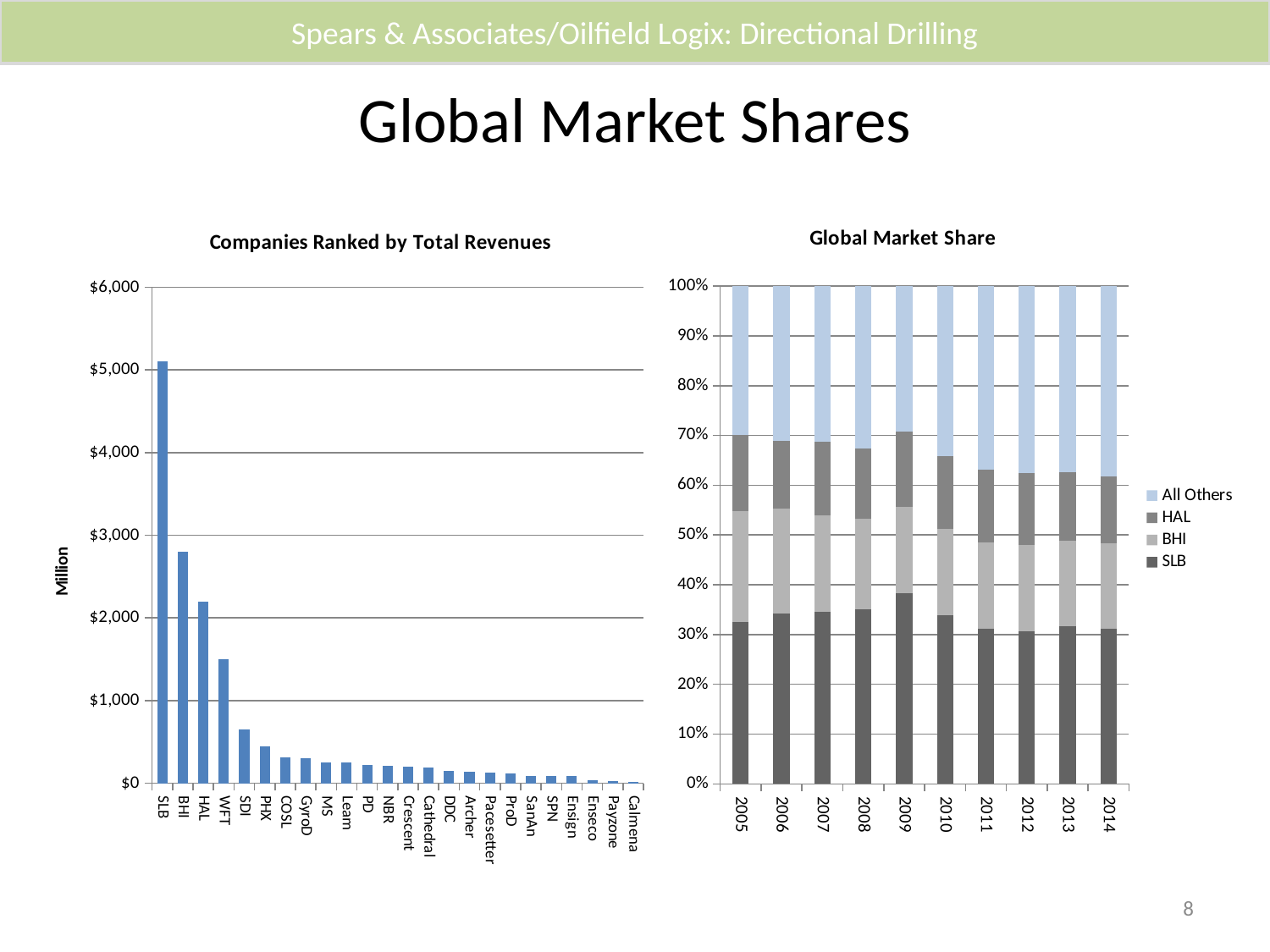
In the 'Global Market Share' chart, is the SLB share in 2009 greater or less than 30%? greater In the 'Companies Ranked by Total Revenues' chart, is the value for WFT greater or less than $1,000? greater In the 'Companies Ranked by Total Revenues' chart, which has the larger revenue, BHI or HAL? BHI How many companies are shown in the 'Companies Ranked by Total Revenues' chart? 24 How many years are shown on the x axis of the 'Global Market Share' chart? 10 In the 'Companies Ranked by Total Revenues' chart, which company has the highest total revenue? SLB In the 'Companies Ranked by Total Revenues' chart, is the value for SLB greater or less than $4,000? greater What kind of chart is the 'Global Market Share' chart? stacked bar chart In the 'Companies Ranked by Total Revenues' chart, do the values rise or fall from left to right along the x axis? fall How many series does the legend of the 'Global Market Share' chart list? 4 In the 'Companies Ranked by Total Revenues' chart, which company has the lowest total revenue? Calmena